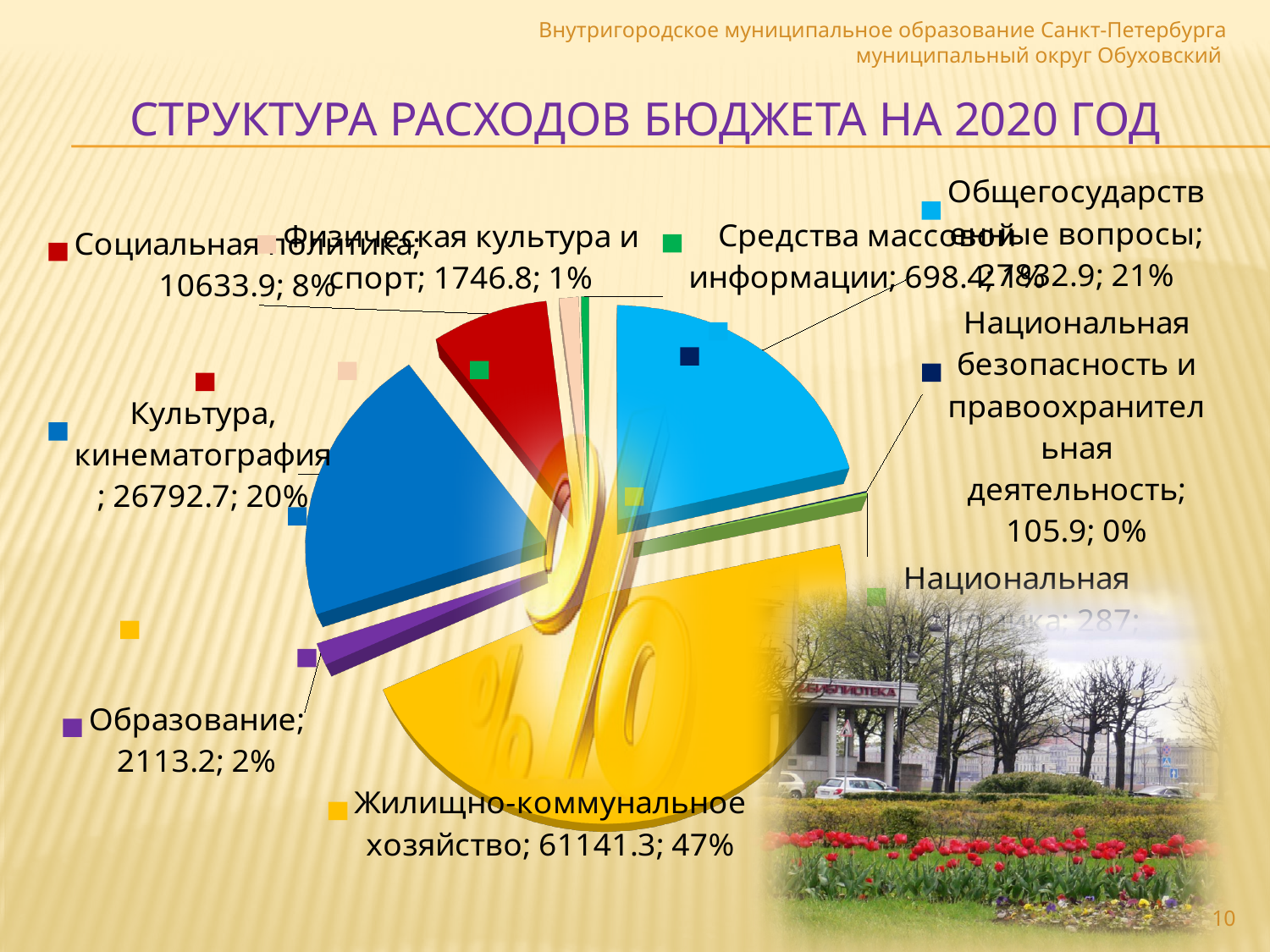
What share of the pie does Культура, кинематография take? 20% What share of the pie does Жилищно-коммунальное хозяйство take? 47% Which category has the smallest slice of the pie? Национальная безопасность и правоохранительная деятельность What is the value for Образование? 2113.2 What kind of chart is shown on the slide? pie chart What is the value for Культура, кинематография? 26792.7 What is the title of the chart? СТРУКТУРА РАСХОДОВ БЮДЖЕТА НА 2020 ГОД Which category has the largest slice of the pie? Жилищно-коммунальное хозяйство What is the value for Социальная политика? 10633.9 What is the value for Жилищно-коммунальное хозяйство? 61141.3 What is the difference between the values for Социальная политика and Образование? 8520.7 Which is larger, Социальная политика or Образование? Социальная политика